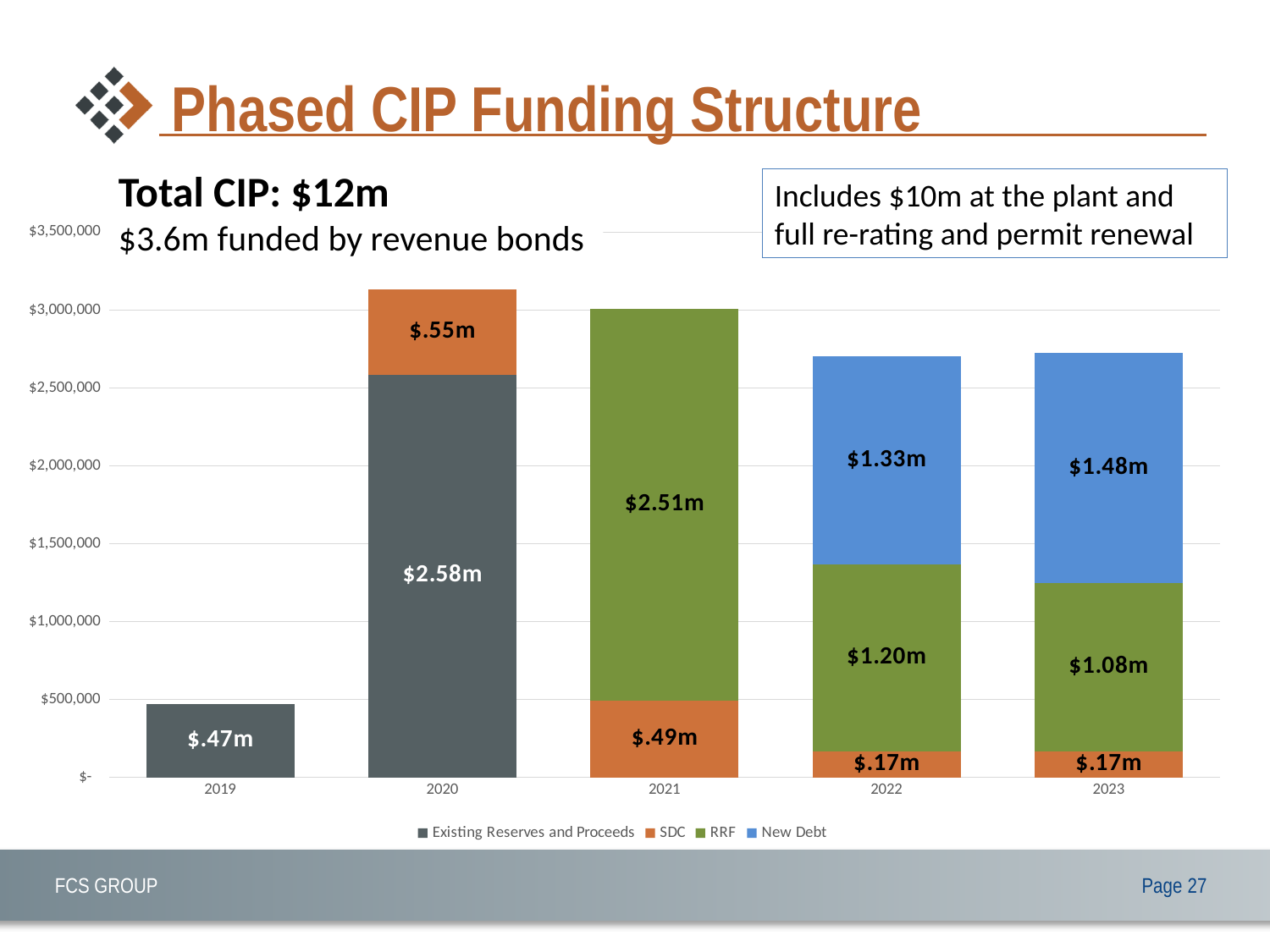
What is the total of the stacked bar for 2022? $2.70m What is the value of Existing Reserves and Proceeds for 2020? $2.58m What is the New Debt value for 2023? $1.48m How many years are shown on the x axis? 5 Which year has the tallest stacked bar overall? 2020 What is the SDC value for 2022? $.17m What is the RRF value for 2021? $2.51m What is the difference between the New Debt values for 2023 and 2022? $.15m How many series does the legend list? 4 Is the total bar for 2019 greater or less than $500,000? less Which is larger, the RRF value for 2022 or the RRF value for 2023? 2022 Which year has the shortest stacked bar overall? 2019